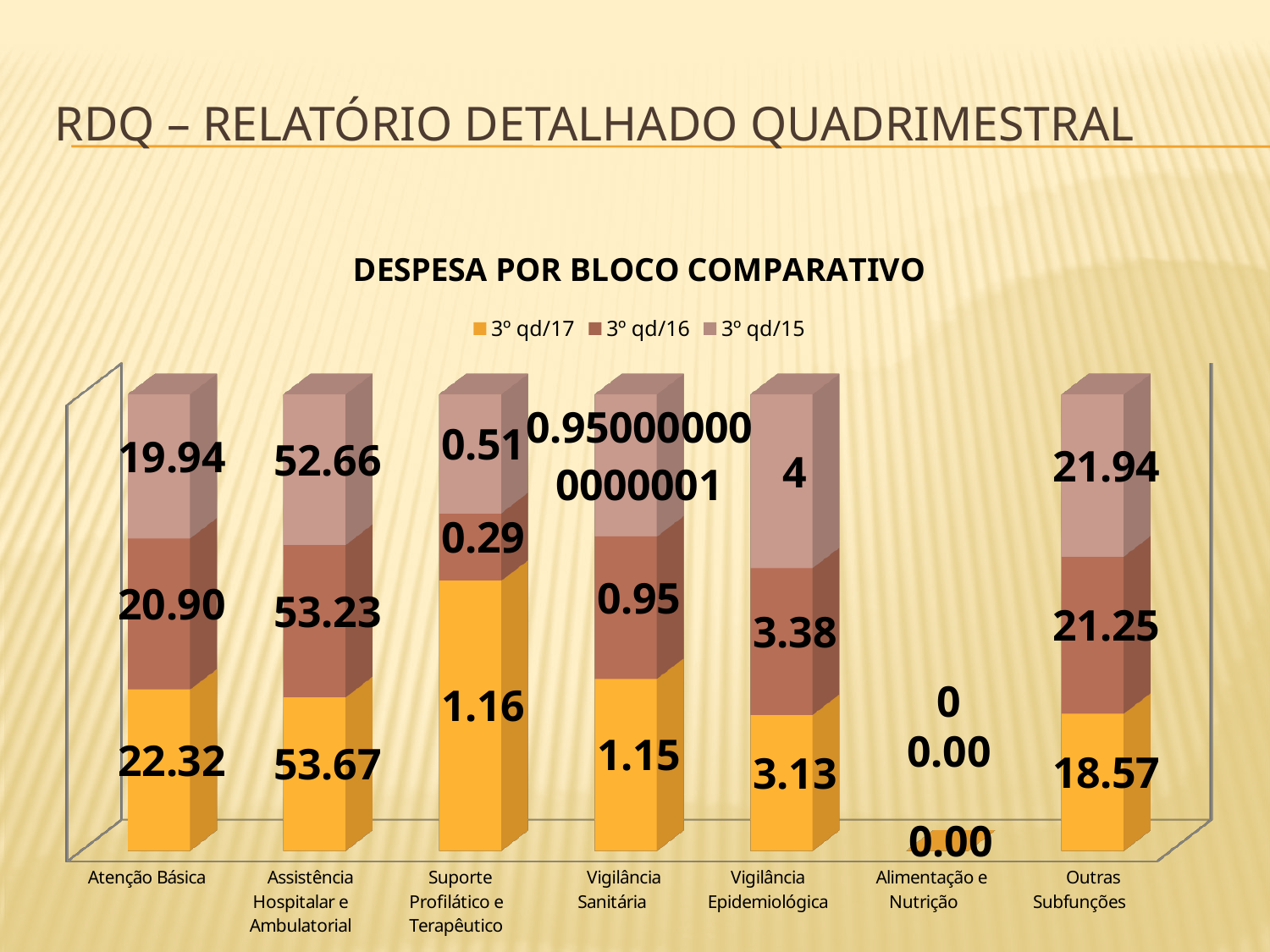
What is the title of the chart? DESPESA POR BLOCO COMPARATIVO How many series does the legend list? 3 What is the value for Outras Subfunções in the 3º qd/16 series? 21.25 Which category has the lowest value in the 3º qd/16 series? Alimentação e Nutrição What is the value for Assistência Hospitalar e Ambulatorial in the 3º qd/15 series? 52.66 What is the difference between the 3º qd/17 and 3º qd/15 values for Atenção Básica? 2.38 What type of chart is shown on the slide? Stacked bar chart For Outras Subfunções, which is larger: the 3º qd/17 value or the 3º qd/16 value? 3º qd/16 What is the value for Atenção Básica in the 3º qd/17 series? 22.32 How many categories are shown on the x axis? 7 What is the value for Vigilância Epidemiológica in the 3º qd/15 series? 4 Which category has the highest value in the 3º qd/17 series? Assistência Hospitalar e Ambulatorial